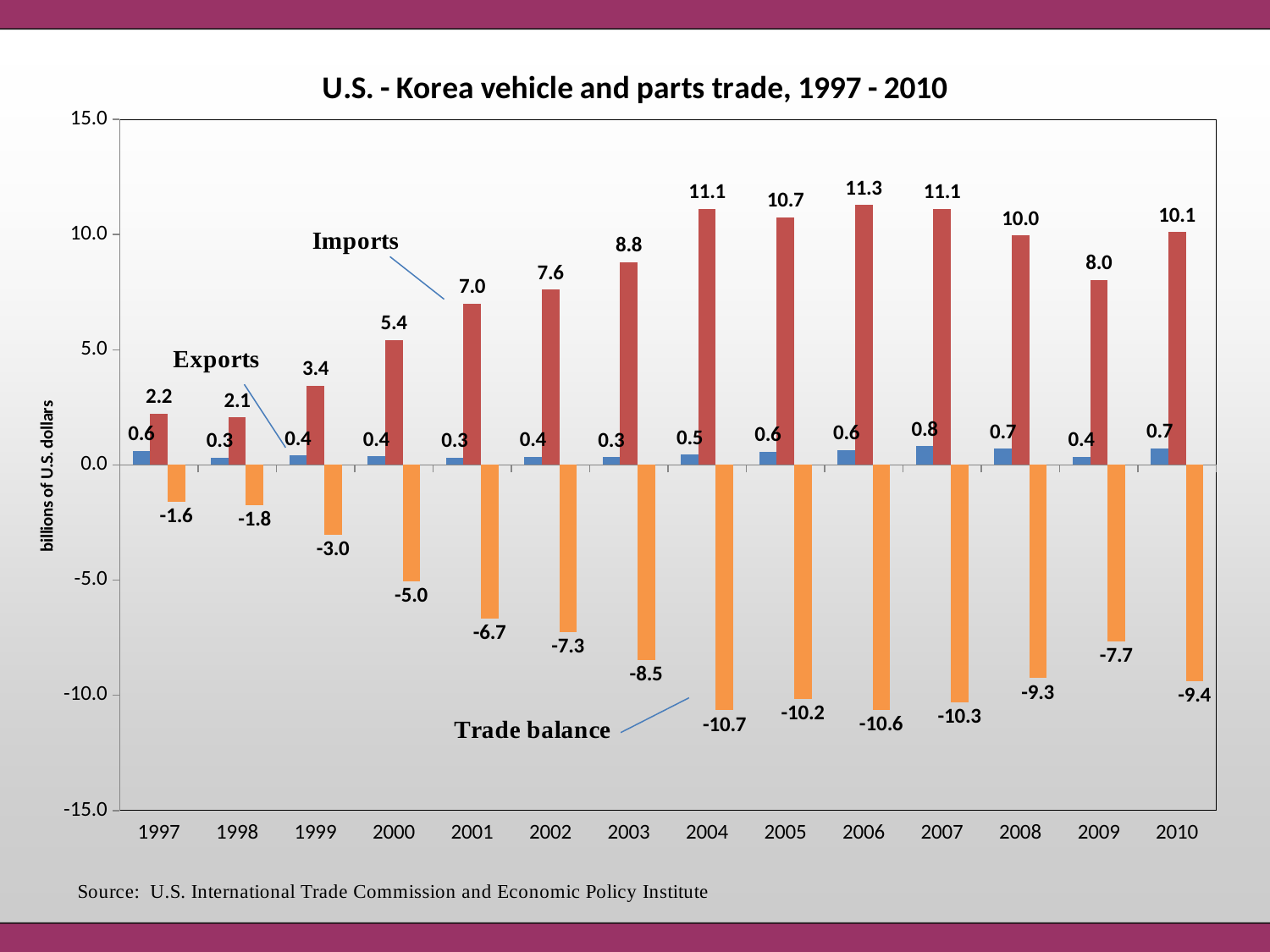
Do Imports generally rise or fall from 1997 to 2006? Rise What is the value of Exports in 2007? 0.8 What is the difference between Imports and Exports in 2010? 9.4 In which year are Imports lowest? 1998 What is the Trade balance value for 2004? -10.7 Which is larger, Imports in 2003 or Imports in 2009? Imports in 2003 What kind of chart is this? Bar chart What is the value of Imports in 2006? 11.3 How many data series does the chart show? 3 What is the title of the chart? U.S. - Korea vehicle and parts trade, 1997 - 2010 How many years are shown on the x axis? 14 In which year are Imports highest? 2006